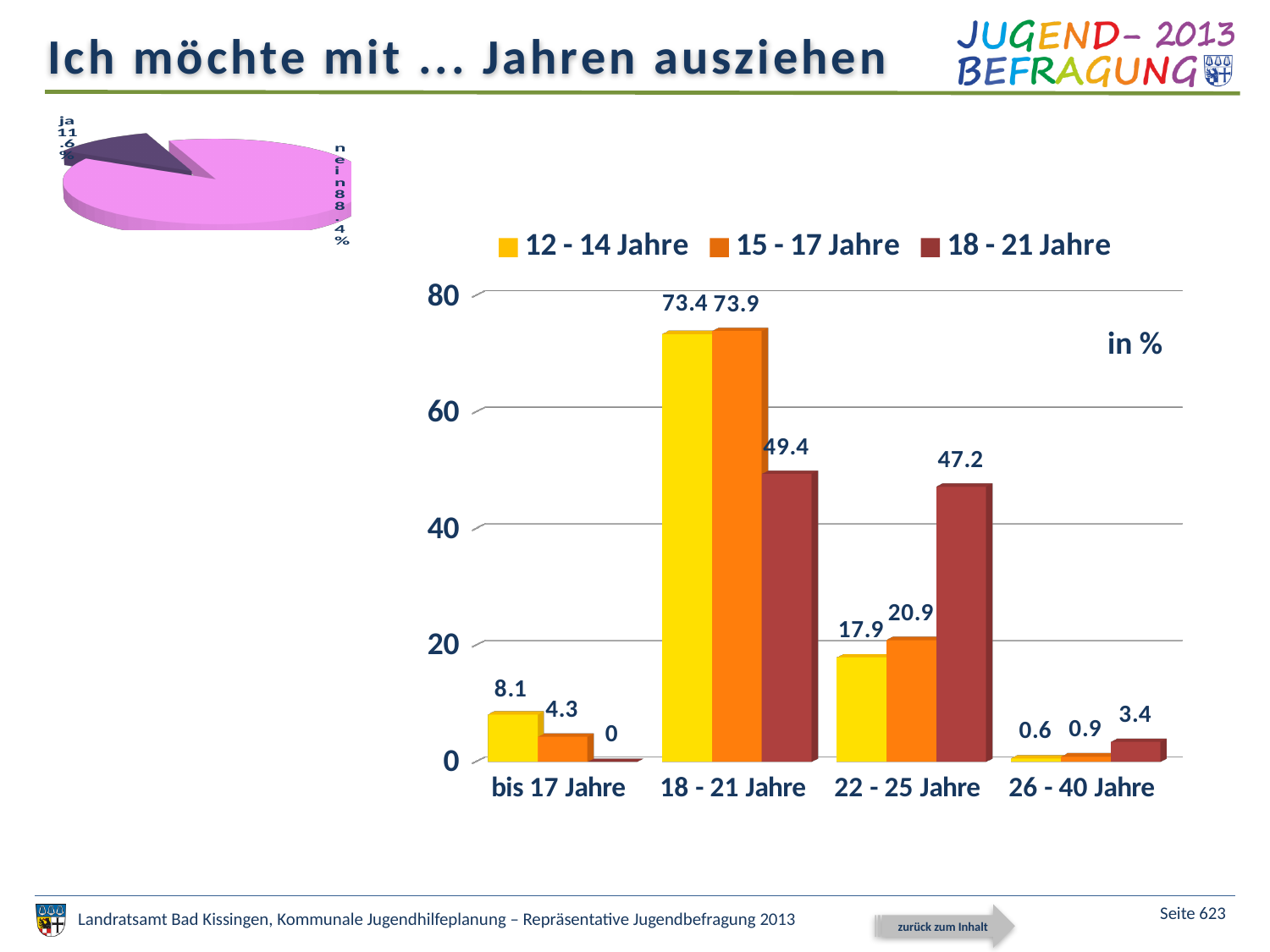
In the bar chart, what is the value for the 18 - 21 Jahre series in the 22 - 25 Jahre category? 47.2 In the bar chart, what is the value for the 12 - 14 Jahre series in the 18 - 21 Jahre category? 73.4 In the bar chart, which category has the highest value for the 18 - 21 Jahre series? 18 - 21 Jahre How many series does the legend of the bar chart list? 3 In the bar chart, what is the value for the 15 - 17 Jahre series in the bis 17 Jahre category? 4.3 In the bar chart, is the value for the 18 - 21 Jahre series in the 18 - 21 Jahre category greater or less than 60? less How many categories are shown on the x axis of the bar chart? 4 In the bar chart, which is larger in the 22 - 25 Jahre category: the 18 - 21 Jahre series or the 15 - 17 Jahre series? 18 - 21 Jahre In the bar chart, what is the difference between the 15 - 17 Jahre and 12 - 14 Jahre values in the 22 - 25 Jahre category? 3.0 What kind of chart is the large chart on the right of the slide? bar chart In the bar chart, which category has the lowest value for the 12 - 14 Jahre series? 26 - 40 Jahre In the pie chart at the top left, what is the share of the 'nein' slice? 88.4%